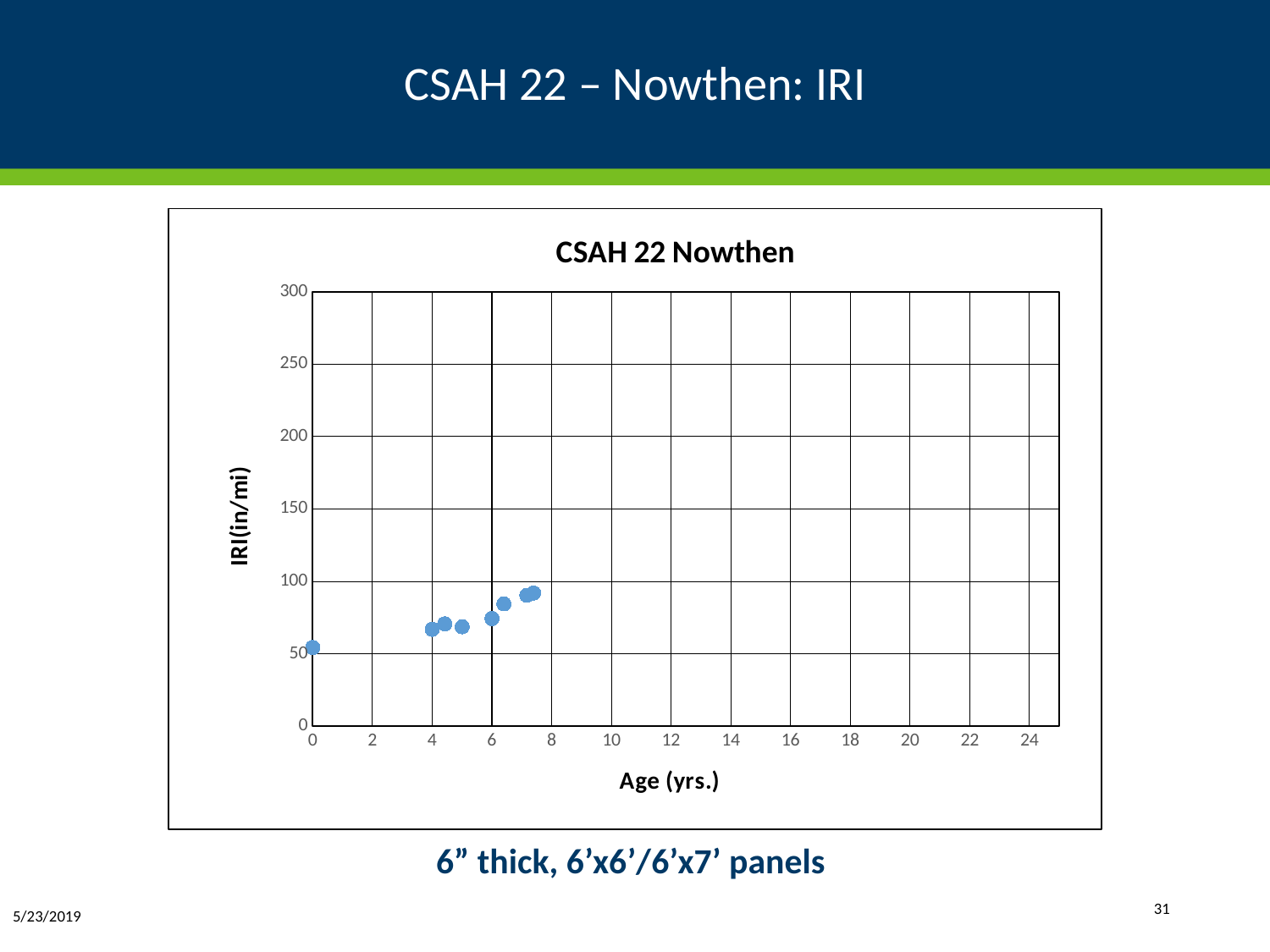
Does the point with the lowest IRI occur at the youngest or the oldest age plotted? youngest Do the IRI values generally rise or fall as age increases? rise Is the IRI value at age 0 greater or less than 100? less Is the highest IRI value plotted greater or less than 100? less Are the IRI values for the points between ages 6 and 8 greater or less than 50? greater Is the IRI value at age 0 larger or smaller than the IRI value at about age 6? smaller What is the label of the vertical axis of the chart? IRI(in/mi) What is the title of the chart? CSAH 22 Nowthen What kind of chart is shown on the slide? scatter chart Does the point with the highest IRI occur at the youngest or the oldest age plotted? oldest